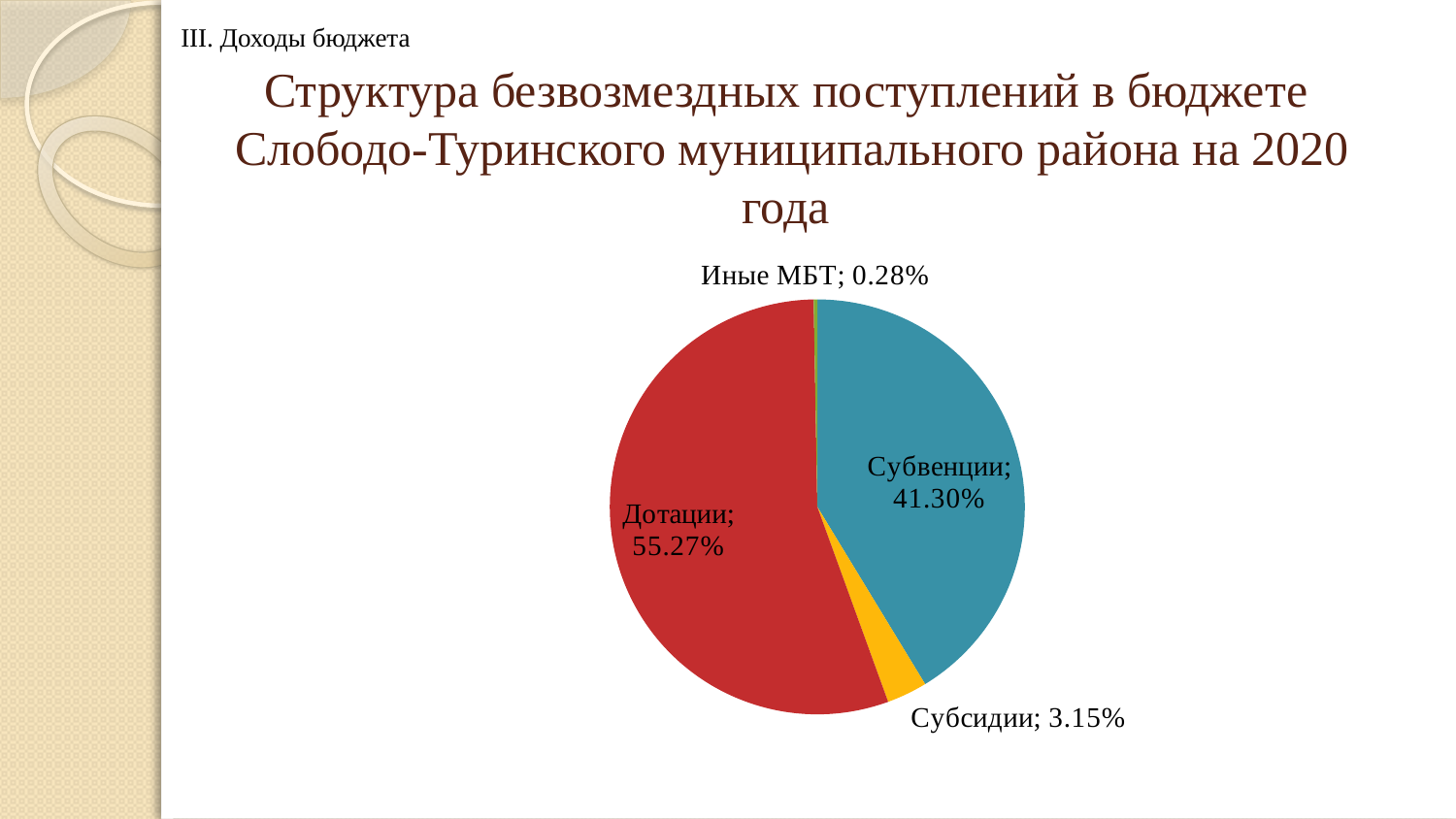
What colour is the Дотации slice? red Which category has the smallest slice of the pie? Иные МБТ What is the difference in percentage points between Дотации and Субвенции? 13.97 What is the difference in percentage points between Субсидии and Иные МБТ? 2.87 What is the share for Иные МБТ? 0.28% What is the share for Дотации? 55.27% Which category has the largest slice of the pie? Дотации What is the share for Субсидии? 3.15% What is the share for Субвенции? 41.30% What kind of chart is shown on the slide? pie chart Which is larger, the share for Субсидии or the share for Иные МБТ? Субсидии How many slices does the pie chart have? 4